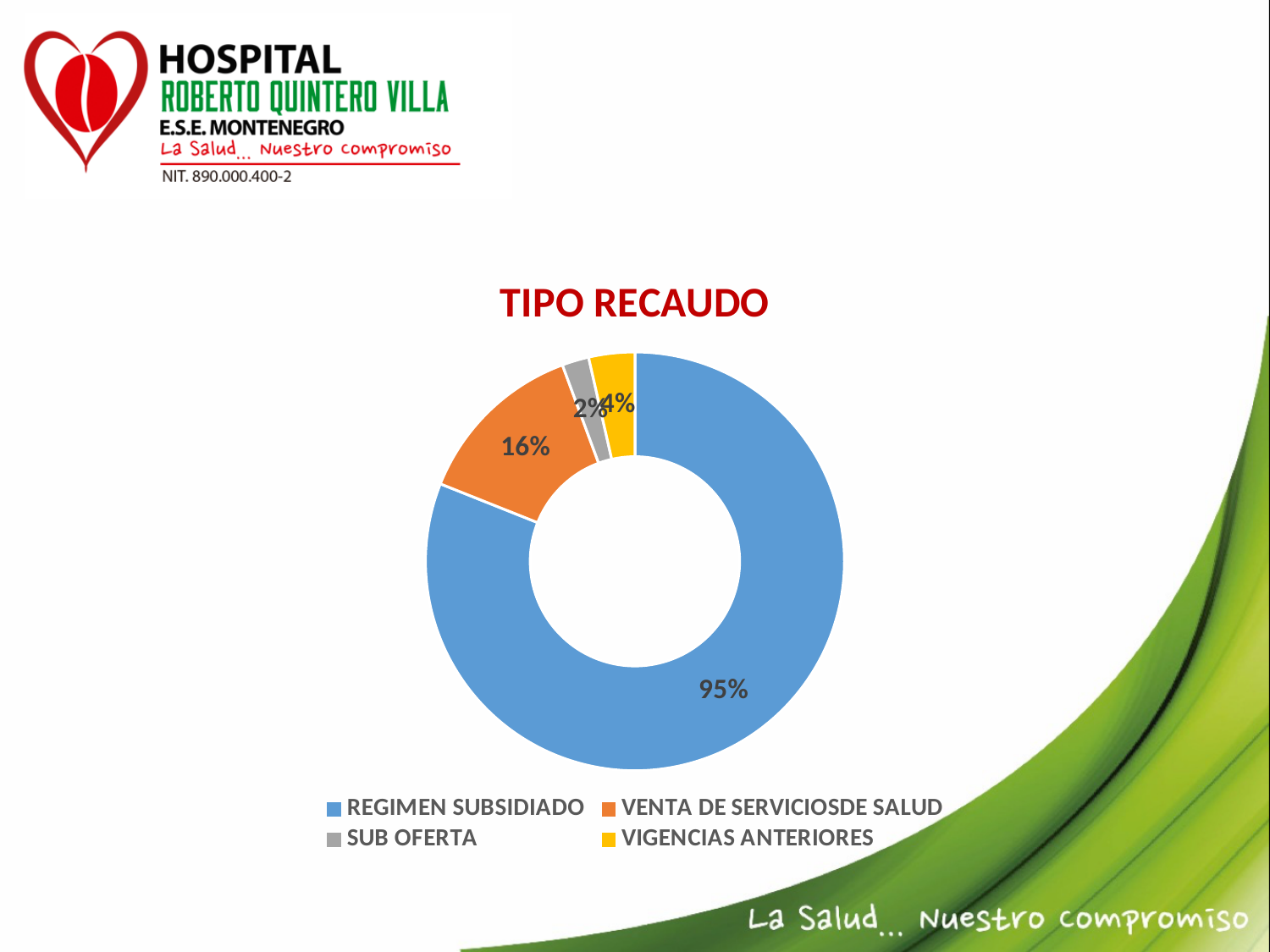
What is the difference in percentage points between REGIMEN SUBSIDIADO and VENTA DE SERVICIOSDE SALUD? 79 percentage points What percentage is shown for VENTA DE SERVICIOSDE SALUD? 16% Which category has the smallest share of the chart? SUB OFERTA What percentage is shown for REGIMEN SUBSIDIADO? 95% What colour represents REGIMEN SUBSIDIADO in the chart? Blue Which is larger, VENTA DE SERVICIOSDE SALUD or VIGENCIAS ANTERIORES? VENTA DE SERVICIOSDE SALUD Which category has the largest share of the chart? REGIMEN SUBSIDIADO What percentage is shown for SUB OFERTA? 2% How many categories does the legend list? 4 What kind of chart is shown on the slide? Doughnut chart What is the title of the chart? TIPO RECAUDO What percentage is shown for VIGENCIAS ANTERIORES? 4%